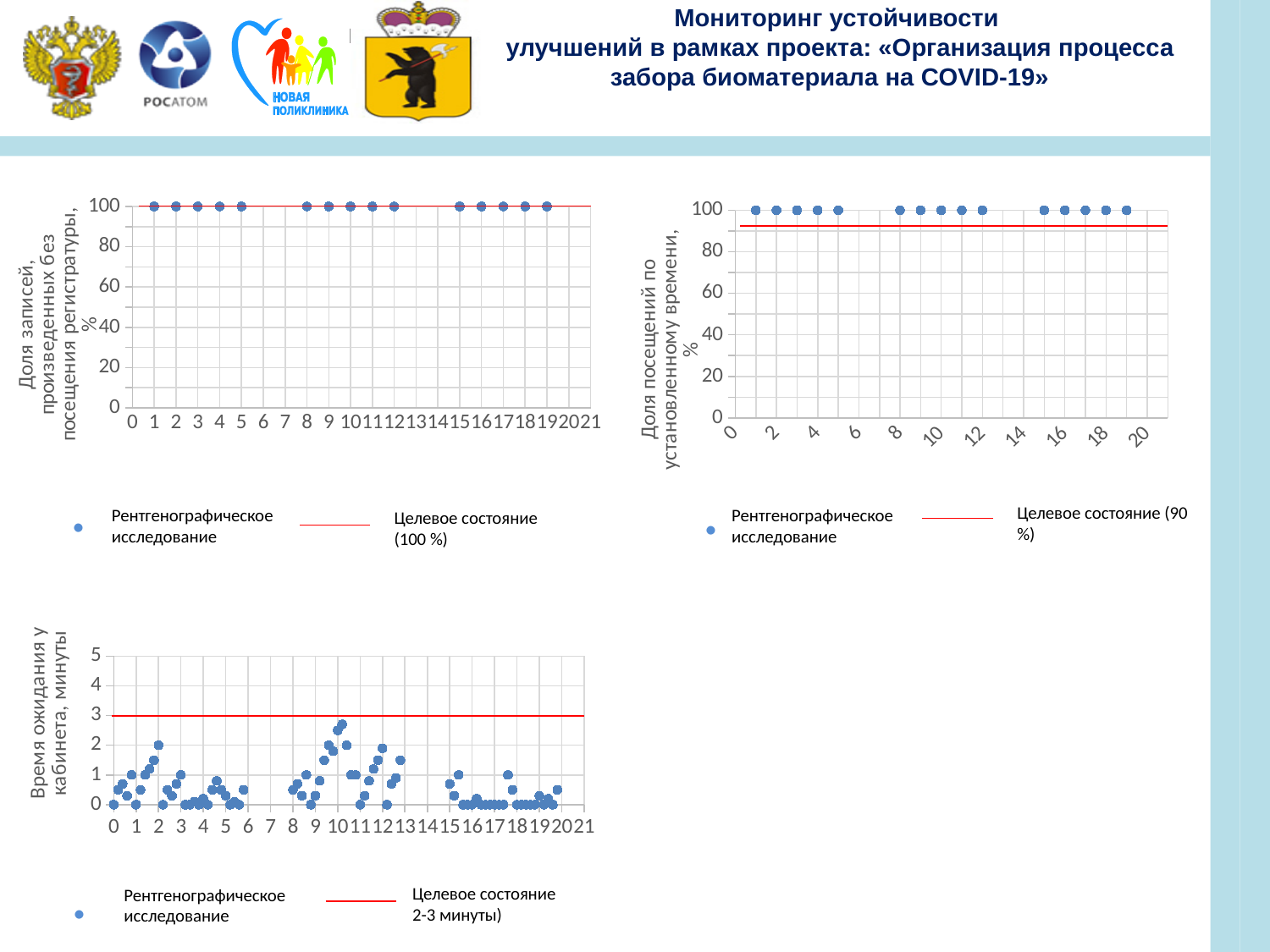
How many series does the legend of the top-right chart (Доля посещений по установленному времени, %) list? 2 In the top-right chart (Доля посещений по установленному времени, %), what is the target level named in the legend for Целевое состояние? 90 % In the top-left chart (Доля записей, произведенных без посещения регистратуры, %), what value do the plotted points for Рентгенографическое исследование take? 100 In the top-left chart (Доля записей, произведенных без посещения регистратуры, %), do the plotted values rise, fall, or stay flat along the x axis? stay flat In the top-right chart (Доля посещений по установленному времени, %), which is larger: the plotted points for Рентгенографическое исследование or the red Целевое состояние line? Рентгенографическое исследование In the top-right chart (Доля посещений по установленному времени, %), is the value of the Рентгенографическое исследование points greater or less than 80? greater What kind of chart is the bottom-left chart (Время ожидания у кабинета, минуты)? scatter chart In the bottom-left chart (Время ожидания у кабинета, минуты), are all the plotted waiting-time points below the red target line of 3 minutes? yes In the bottom-left chart (Время ожидания у кабинета, минуты), what is the highest value shown on the y axis? 5 What kind of chart is the top-left chart (Доля записей, произведенных без посещения регистратуры, %)? scatter chart In the bottom-left chart (Время ожидания у кабинета, минуты), is the red target line greater or less than 2? greater In the top-left chart (Доля записей, произведенных без посещения регистратуры, %), what target value is given in the legend for Целевое состояние? 100 %